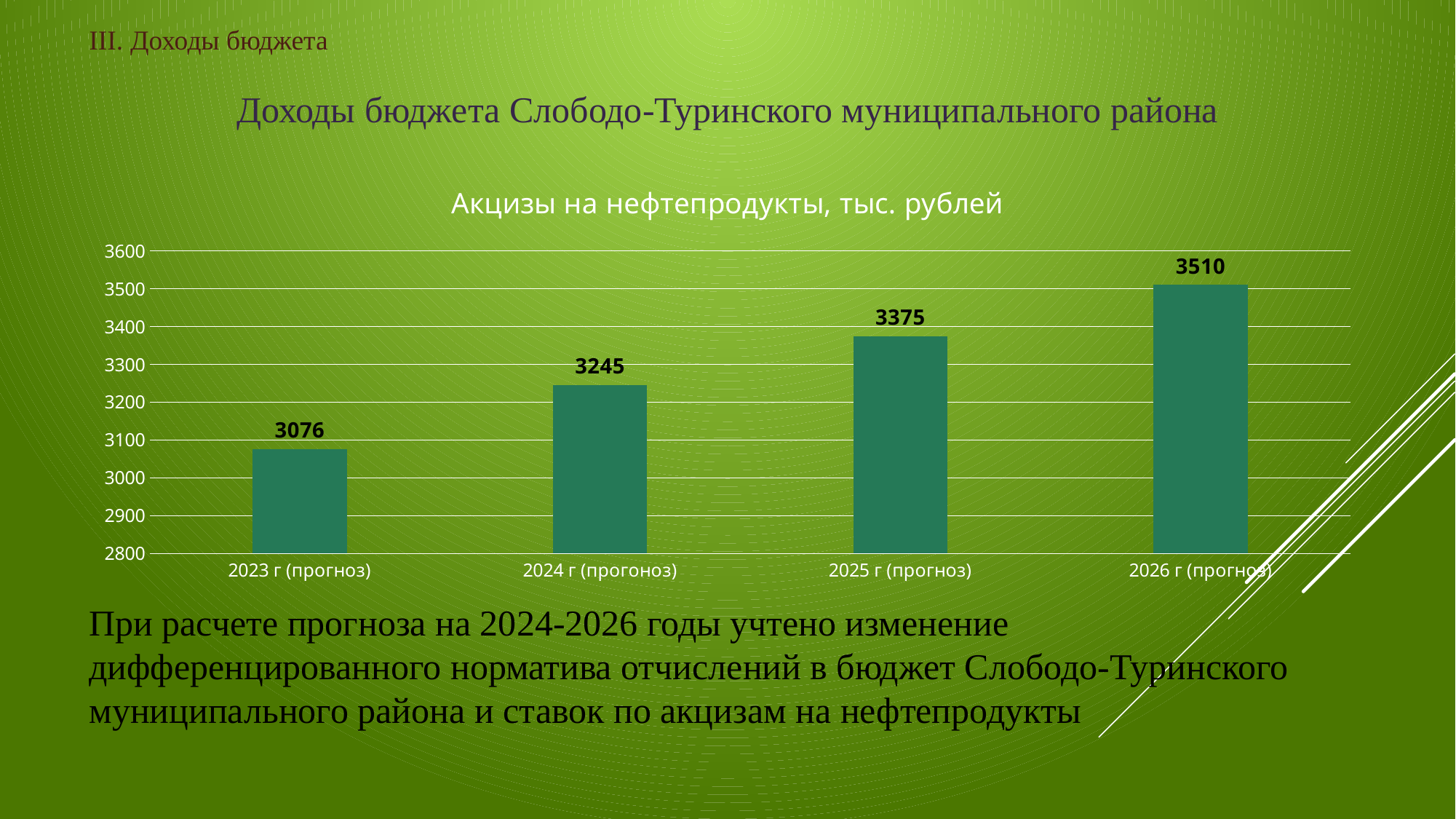
What is the value for 2023 г (прогноз)? 3076 Which year has the lowest value? 2023 г (прогноз) What is the difference between the values for 2026 г (прогноз) and 2023 г (прогноз)? 434 Do the values rise or fall from 2023 to 2026? rise What kind of chart is this? bar chart What is the value for 2026 г (прогноз)? 3510 What is the value for 2024 г (прогоноз)? 3245 How many categories are shown on the x axis? 4 Which year has the highest value? 2026 г (прогноз) What is the difference between the values for 2025 г (прогноз) and 2024 г (прогоноз)? 130 What is the value for 2025 г (прогноз)? 3375 Which is larger, the value for 2024 г (прогоноз) or the value for 2025 г (прогноз)? 2025 г (прогноз)